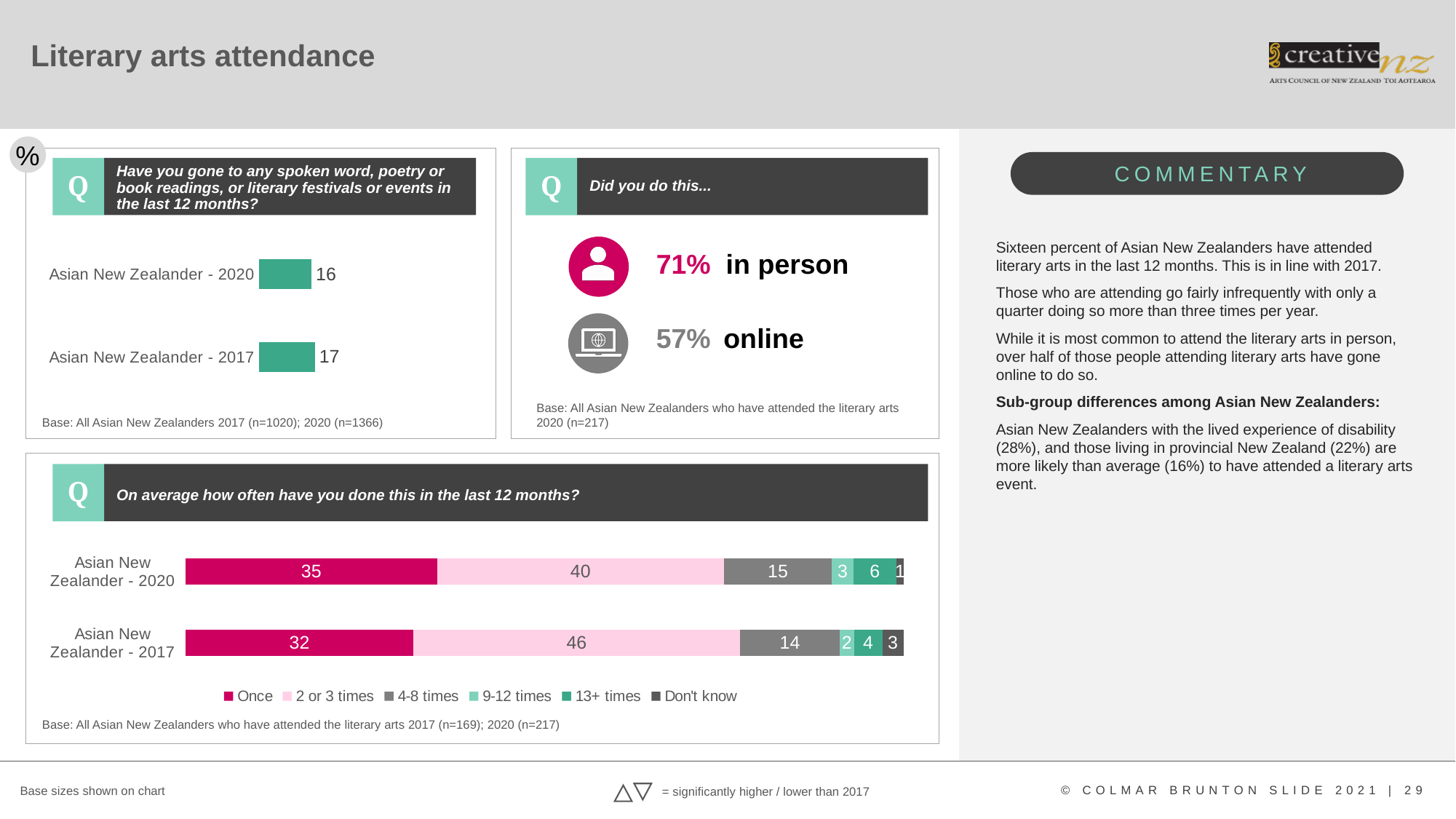
In the top-left chart on attendance in the last 12 months, what is the value for Asian New Zealander - 2017? 17 In the bottom chart on how often people attended, which segment is largest for Asian New Zealander - 2020? 2 or 3 times In the bottom chart on how often people attended, what is the '4-8 times' value for Asian New Zealander - 2020? 15 In the top-left chart on attendance in the last 12 months, how many bars are shown? 2 In the bottom chart on how often people attended, what is the difference between the '2 or 3 times' values for 2017 and 2020? 6 In the bottom chart on how often people attended, what is the 'Once' value for Asian New Zealander - 2020? 35 In the top-left chart on attendance in the last 12 months, what is the difference between the 2017 and 2020 values? 1 In the bottom chart on how often people attended, how many series does the legend list? 6 In the top-left chart on attendance in the last 12 months, what is the value for Asian New Zealander - 2020? 16 In the bottom chart on how often people attended, which is larger: the 'Once' value for 2020 or for 2017? 2020 In the bottom chart on how often people attended, what is the '2 or 3 times' value for Asian New Zealander - 2017? 46 What type of chart is the bottom chart on how often people attended in the last 12 months? Stacked bar chart